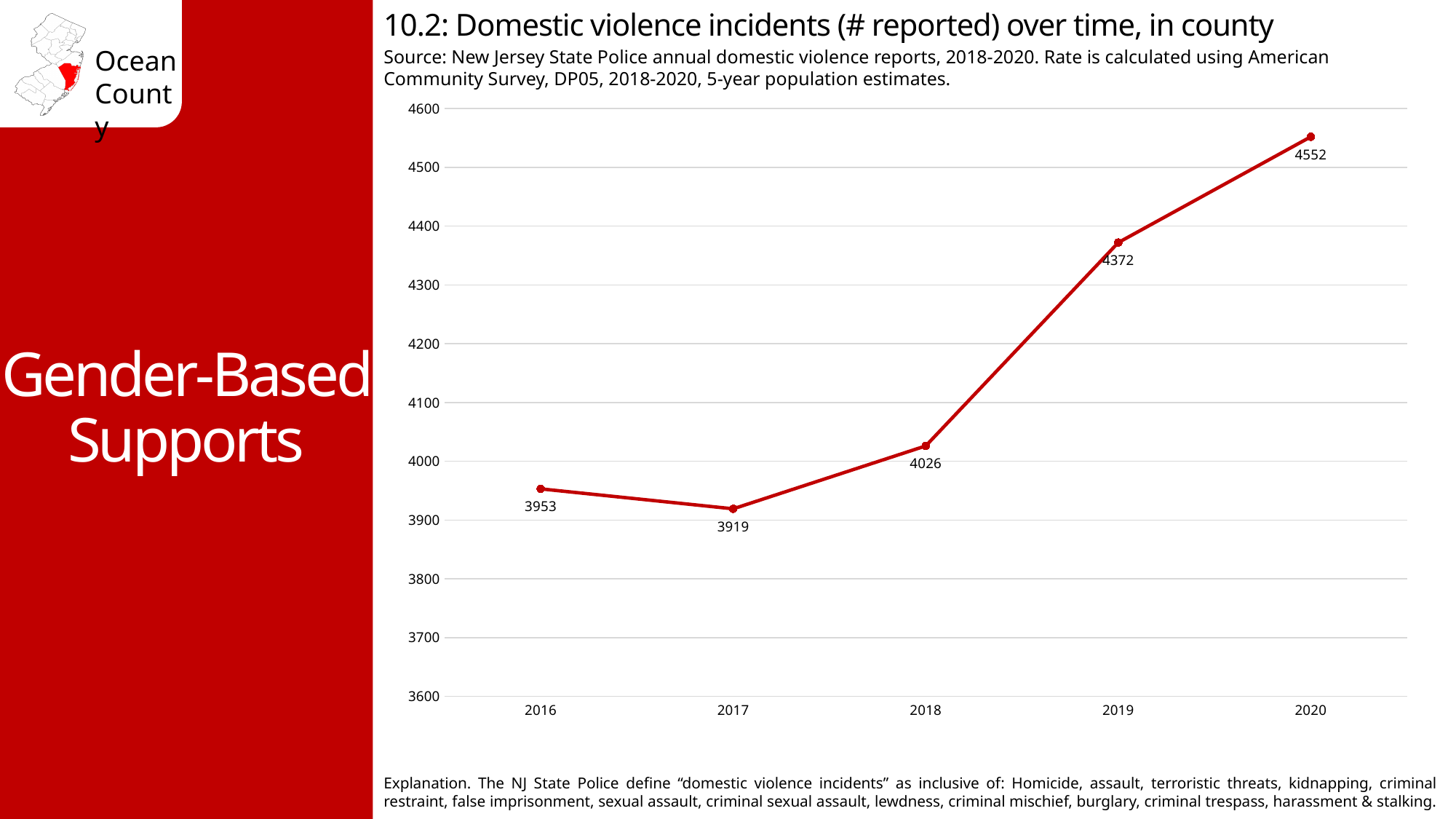
How many more incidents were reported in 2020 than in 2019? 180 What type of chart is shown on the slide? Line chart Which year had the highest number of reported domestic violence incidents? 2020 What was the number of reported domestic violence incidents in 2017? 3919 What was the number of reported domestic violence incidents in 2019? 4372 Which year had the lowest number of reported domestic violence incidents? 2017 What was the number of reported domestic violence incidents in 2020? 4552 Did the number of reported incidents rise or fall from 2017 to 2020? Rise What was the number of reported domestic violence incidents in 2016? 3953 Which year had more reported incidents, 2016 or 2018? 2018 How many years are plotted on the chart? 5 What is the difference between the 2018 and 2017 values? 107